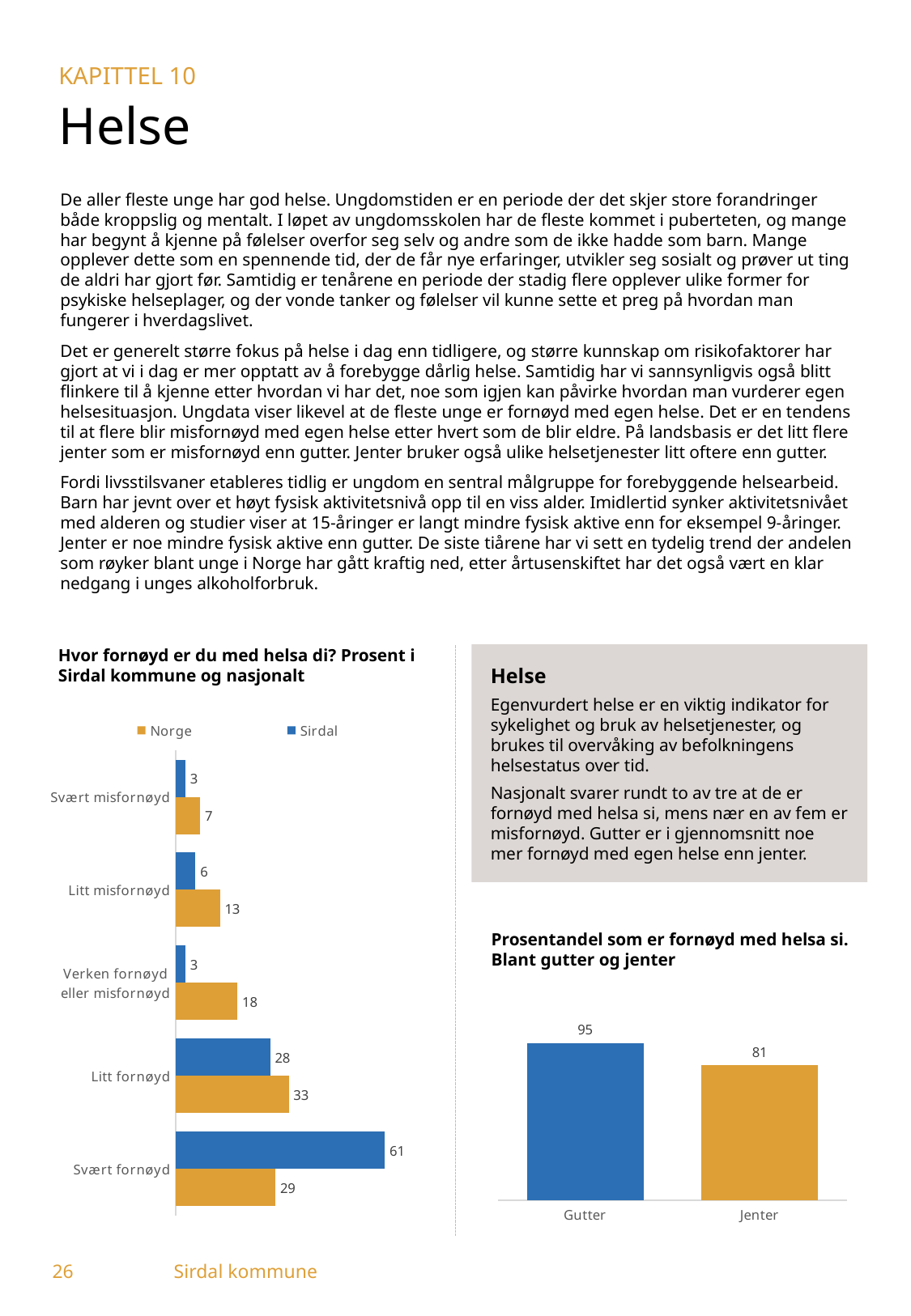
In the chart 'Hvor fornøyd er du med helsa di?', what is the value for Norge in the 'Litt misfornøyd' category? 13 In the chart 'Prosentandel som er fornøyd med helsa si', what is the difference between Gutter and Jenter? 14 In the chart 'Prosentandel som er fornøyd med helsa si', what is the value for Jenter? 81 In the chart 'Hvor fornøyd er du med helsa di?', which category has the lowest value for Norge? Svært misfornøyd How many series does the legend list in the chart 'Hvor fornøyd er du med helsa di?'? 2 What type of chart is 'Prosentandel som er fornøyd med helsa si. Blant gutter og jenter'? Bar chart In the chart 'Hvor fornøyd er du med helsa di?', what is the difference between Sirdal and Norge in the 'Svært fornøyd' category? 32 In the chart 'Hvor fornøyd er du med helsa di?', what is the value for Sirdal in the 'Svært fornøyd' category? 61 How many categories are shown in the chart 'Hvor fornøyd er du med helsa di?'? 5 In the chart 'Hvor fornøyd er du med helsa di?', what is the value for Norge in the 'Verken fornøyd eller misfornøyd' category? 18 In the chart 'Hvor fornøyd er du med helsa di?', which category has the highest value for Sirdal? Svært fornøyd In the chart 'Hvor fornøyd er du med helsa di?', which is larger in the 'Litt fornøyd' category, Norge or Sirdal? Norge